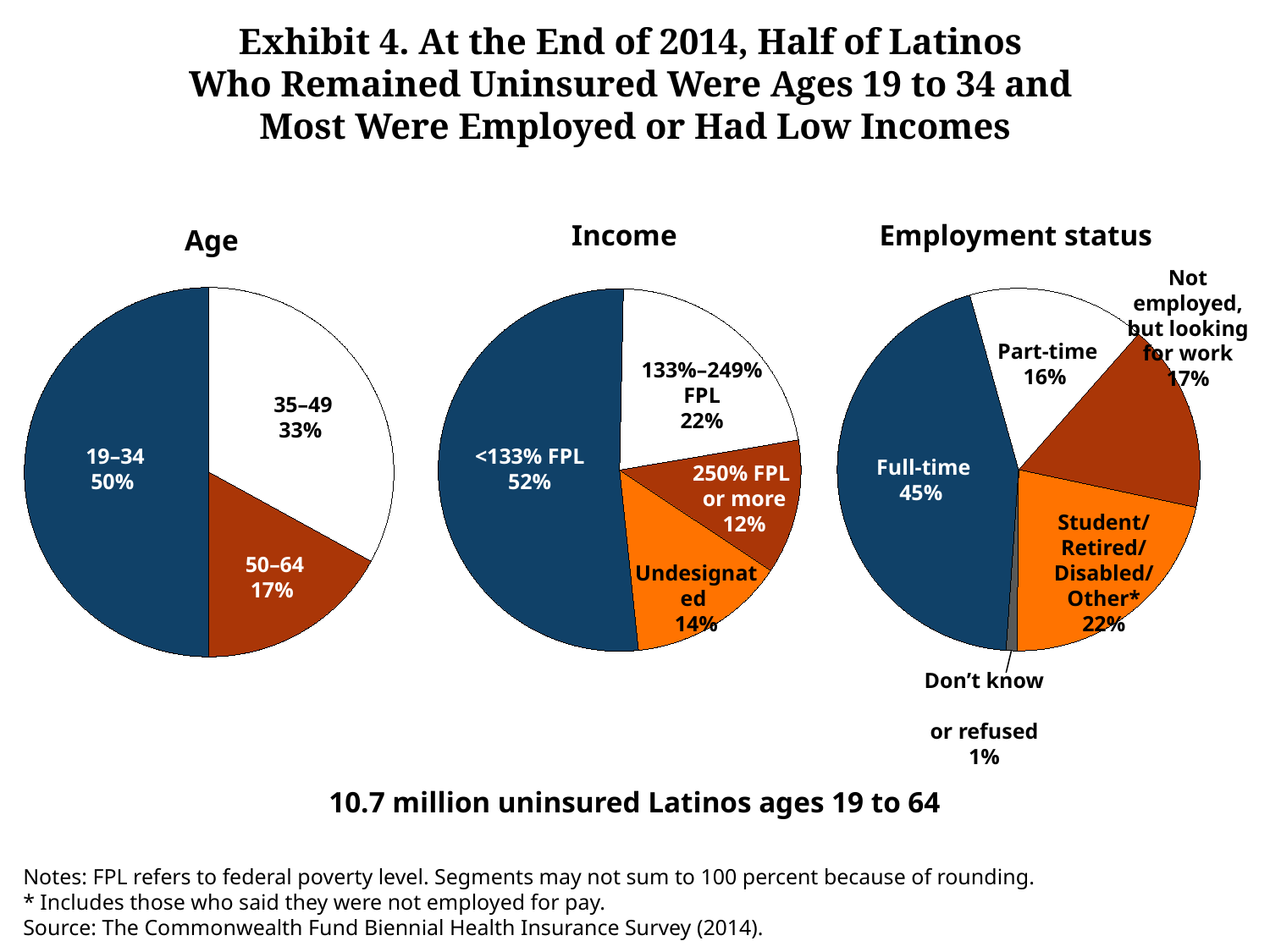
In the Age pie chart, what is the difference between the 35–49 share and the 50–64 share? 16 percentage points In the Employment status pie chart, what share of uninsured Latinos were employed full-time? 45% In the Income pie chart, which is larger: the share for 250% FPL or more, or the share for Undesignated? Undesignated In the Employment status pie chart, which category has the smallest share? Don't know or refused In the Income pie chart, what share of uninsured Latinos had incomes below 133% FPL? 52% In the Income pie chart, how many slices are there? 4 In the Income pie chart, which income category has the largest share? <133% FPL In the Age pie chart, what share of uninsured Latinos were ages 19–34? 50% In the Age pie chart, which age group has the smallest share? 50–64 What kind of charts are shown on the slide? Pie charts In the Employment status pie chart, what is the difference between the Full-time share and the Part-time share? 29 percentage points In the Employment status pie chart, how many categories are shown? 5